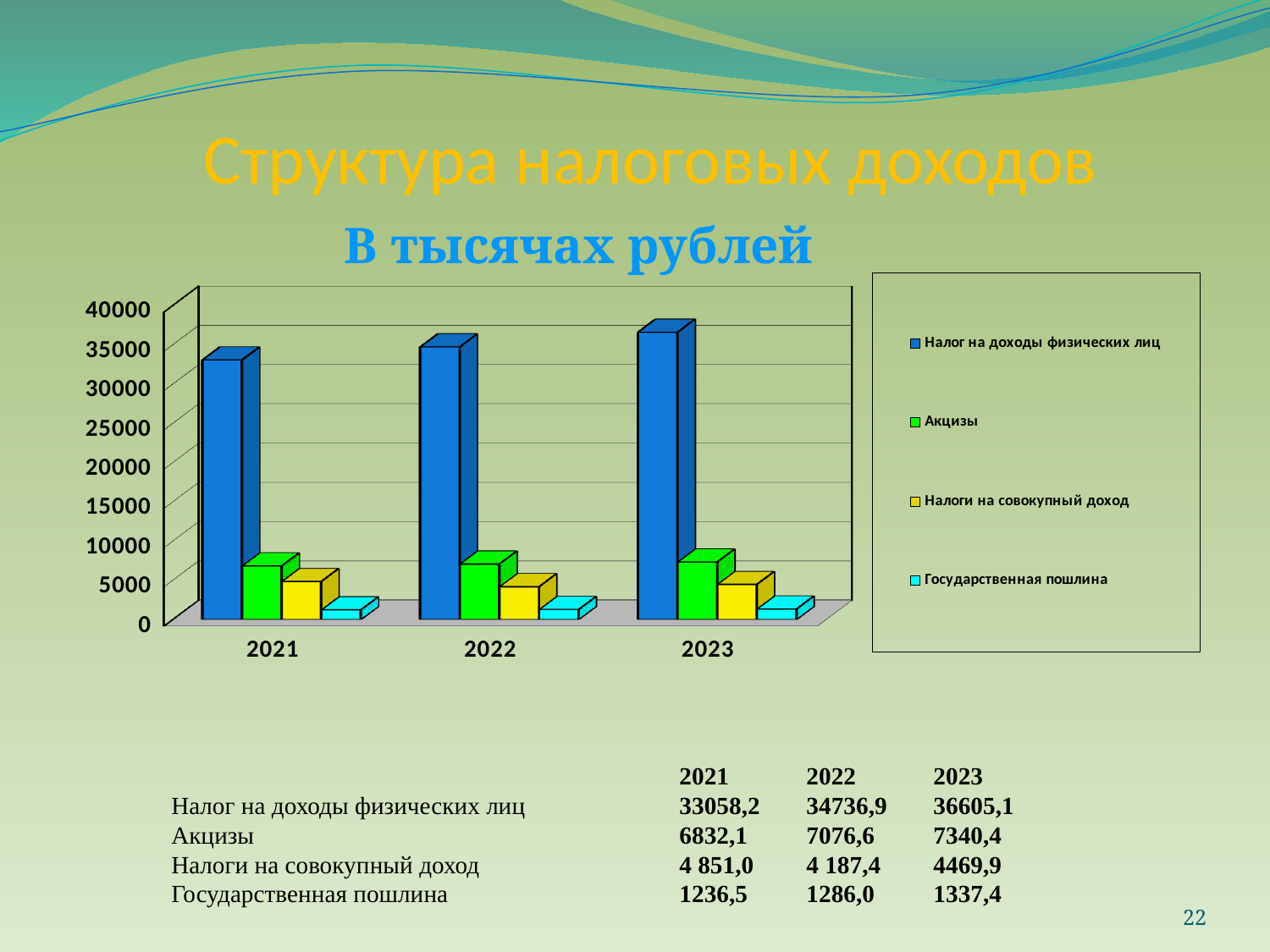
What kind of chart is shown on the slide? bar chart How many series does the chart legend list? 4 What is the value of Налог на доходы физических лиц for 2023? 36605,1 What is the value of Государственная пошлина for 2022? 1286,0 Is the value for Налог на доходы физических лиц in 2021 greater or less than 30000? greater In which year is Налог на доходы физических лиц highest? 2023 How many years are shown on the x axis of the chart? 3 By how much did Налог на доходы физических лиц increase from 2021 to 2023? 3546,9 Which is larger in 2022: Акцизы or Налоги на совокупный доход? Акцизы Does Налог на доходы физических лиц rise or fall from 2021 to 2023? rise Which series has the lowest value in 2021? Государственная пошлина What is the value of Акцизы for 2021? 6832,1